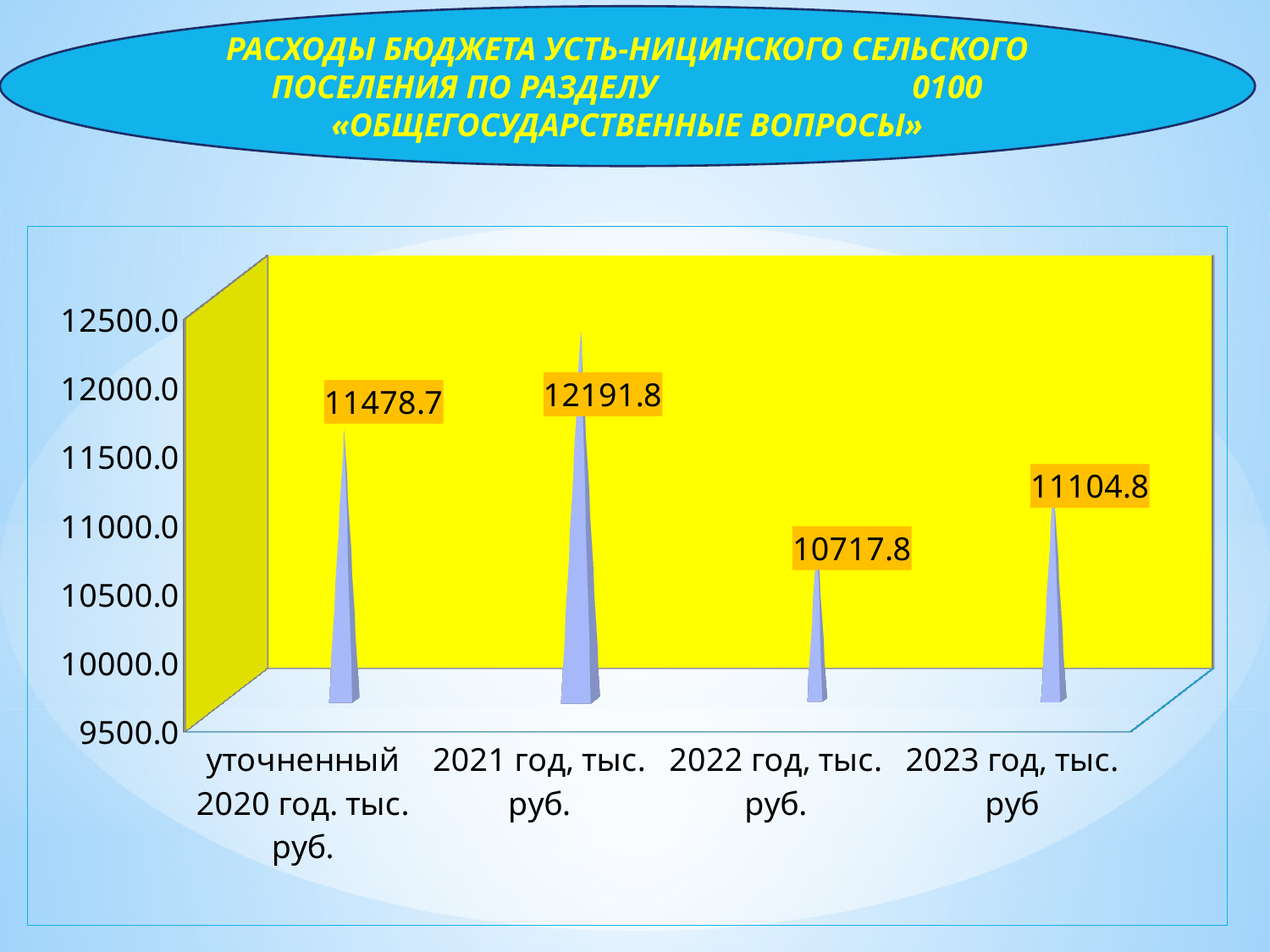
What is the value for уточненный 2020 год. тыс. руб.? 11478.7 Which is larger, the value for уточненный 2020 год or the value for 2023 год? уточненный 2020 год. тыс. руб. What is the difference between the values for уточненный 2020 год and 2023 год? 373.9 Does the value rise or fall from 2021 год to 2022 год? fall What is the value for 2021 год, тыс. руб.? 12191.8 What is the value for 2023 год, тыс. руб? 11104.8 What kind of chart is shown on the slide? bar chart Which category has the lowest value? 2022 год, тыс. руб. How many categories are shown on the x axis? 4 Which category has the highest value? 2021 год, тыс. руб. What is the value for 2022 год, тыс. руб.? 10717.8 What is the difference between the values for 2021 год and 2022 год? 1474.0